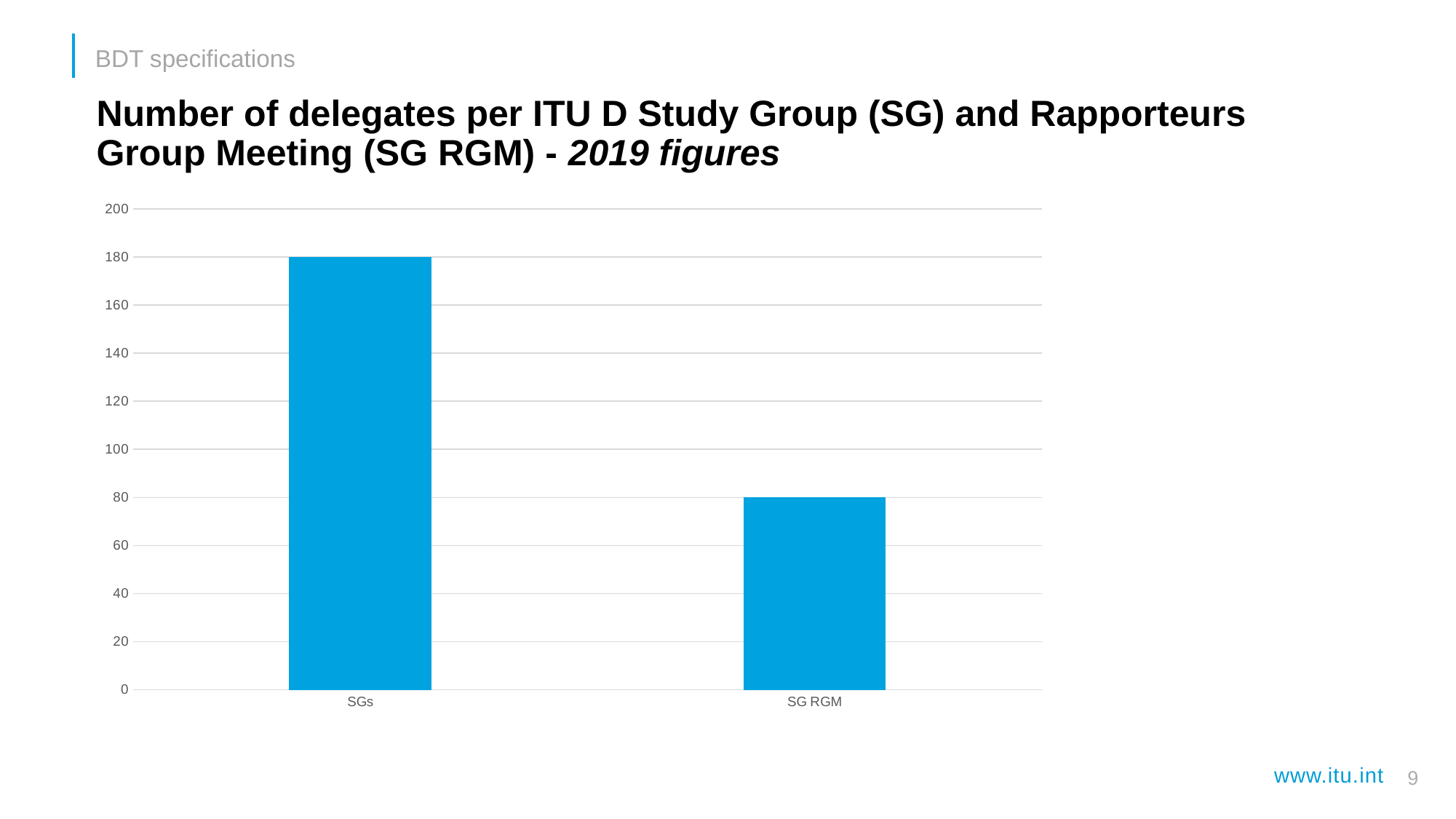
Is the value for SG RGM greater or less than 100? less What is the number of delegates for SG RGM? 80 Which year do the figures in the chart refer to? 2019 Which has more delegates, SGs or SG RGM? SGs What is the difference between the number of delegates for SGs and for SG RGM? 100 Which category has the highest number of delegates? SGs What is the highest value shown on the y axis? 200 What kind of chart is shown on the slide? bar chart What is the number of delegates for SGs? 180 Is the value for SGs greater or less than 160? greater How many categories are shown on the x axis? 2 Which category has the lowest number of delegates? SG RGM